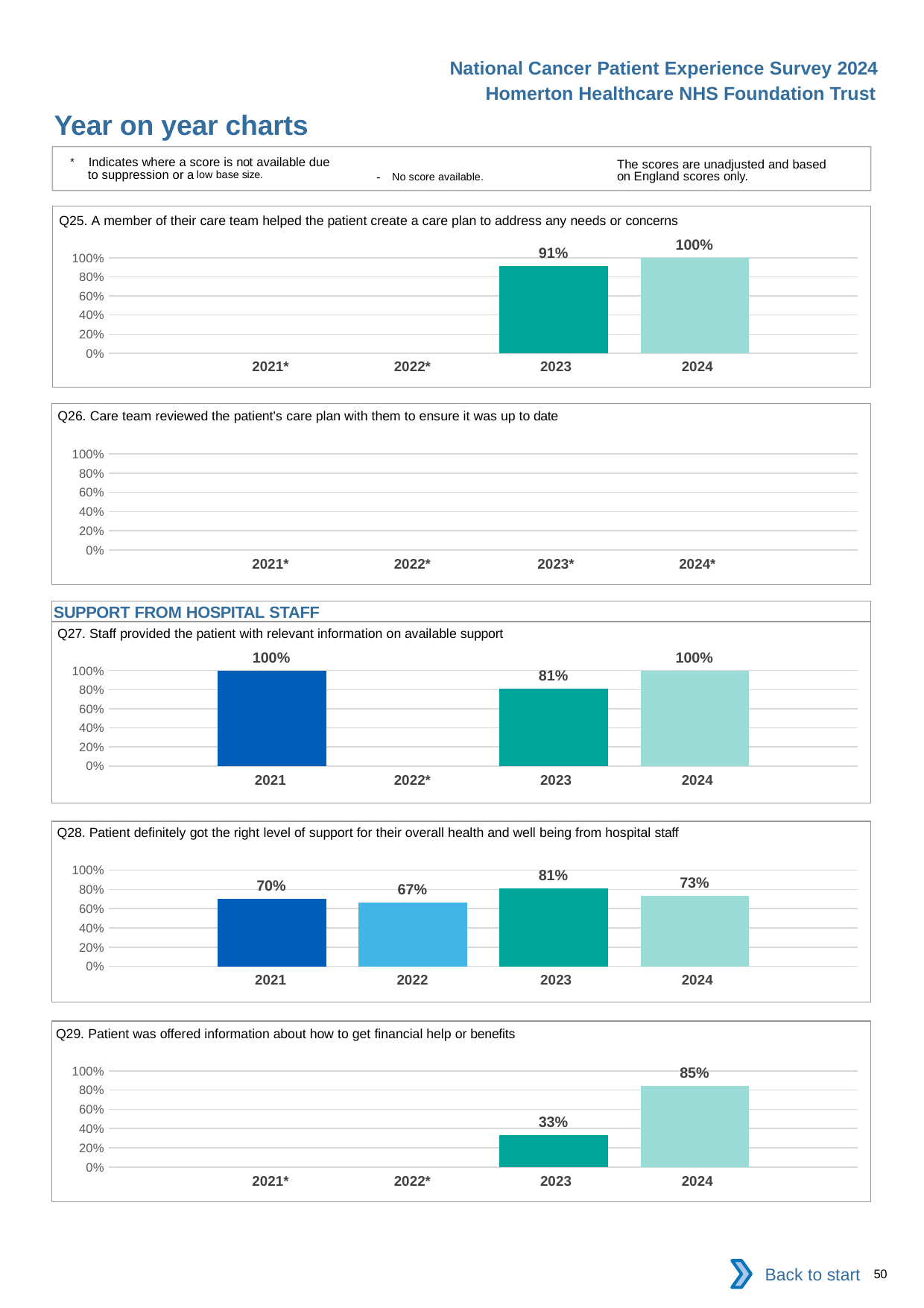
In the Q28 chart, what is the difference between the 2023 and 2024 values? 8% In the Q29 chart, what is the value for 2023? 33% In the Q29 chart, is the value for 2024 larger or smaller than the value for 2023? larger In the Q26 chart, how many years have a plotted bar? 0 In the Q25 chart, what is the value for 2023? 91% In the Q28 chart, what is the value for 2022? 67% In the Q27 chart, what is the value for 2023? 81% In the Q28 chart, how many years have a plotted bar? 4 In the Q25 chart, what is the value for 2024? 100% What kind of chart is the Q29 chart? bar chart In the Q27 chart, which year has the lowest value among the plotted bars? 2023 In the Q28 chart, which year has the highest value? 2023